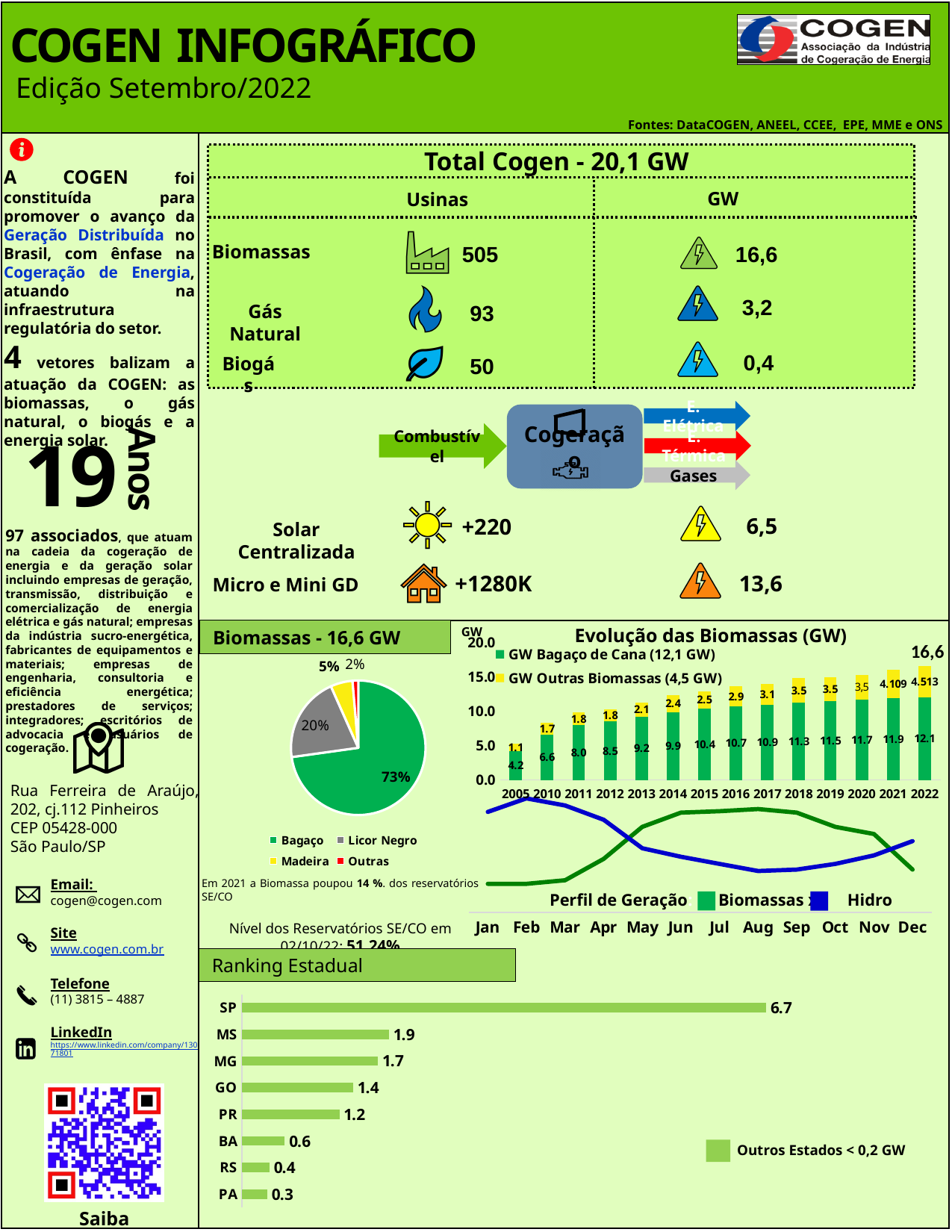
In the 'Ranking Estadual' bar chart, what is the value for SP? 6.7 In the 'Ranking Estadual' bar chart, which is larger, the value for GO or the value for PR? GO In the 'Evolução das Biomassas (GW)' chart, what is the value of GW Outras Biomassas for 2005? 1.1 In the 'Ranking Estadual' bar chart, what is the difference between the values for MS and MG? 0.2 In the 'Biomassas - 16,6 GW' pie chart, how many categories does the legend list? 4 In the 'Evolução das Biomassas (GW)' chart, what is the value of GW Bagaço de Cana for 2022? 12.1 What kind of chart is the 'Evolução das Biomassas (GW)' chart? stacked bar chart In the 'Ranking Estadual' bar chart, which state has the lowest value? PA In the 'Biomassas - 16,6 GW' pie chart, what share does Bagaço have? 73% In the 'Ranking Estadual' bar chart, how many states are shown as bars? 8 In the 'Evolução das Biomassas (GW)' chart, do the GW Bagaço de Cana values rise or fall from 2005 to 2022? rise In the 'Biomassas - 16,6 GW' pie chart, which category has the smallest slice? Outras